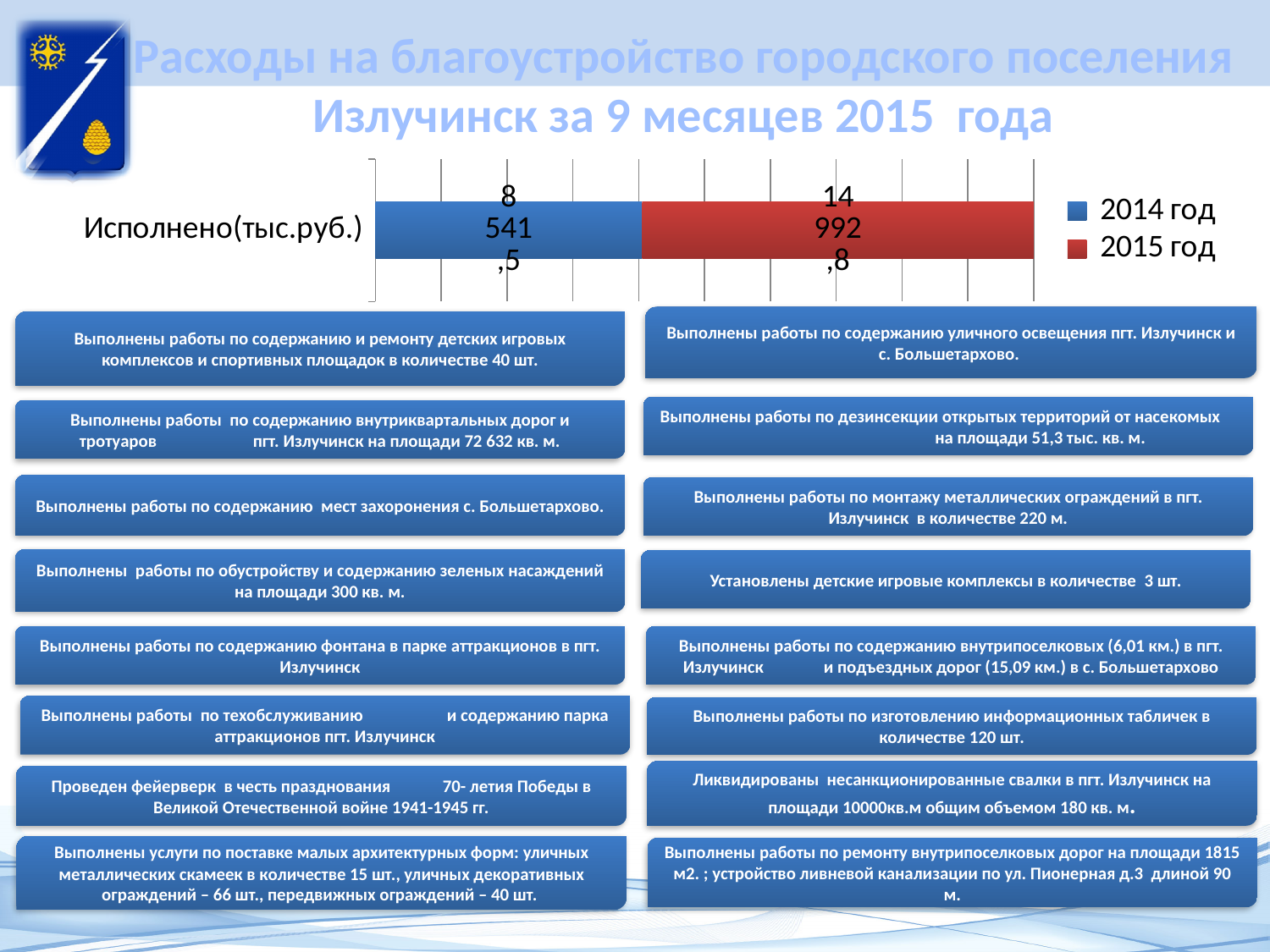
What is the difference between the 2015 год and 2014 год values? 6 451,3 Which series has the larger value, 2014 год or 2015 год? 2015 год How many categories are shown on the chart's axis? 1 What colour represents 2015 год in the chart? Red What is the category label shown on the chart's axis? Исполнено(тыс.руб.) What is the value for 2015 год in the chart? 14 992,8 What kind of chart is shown on the slide? Stacked bar chart What is the total of the stacked bar for Исполнено(тыс.руб.)? 23 534,3 Which year has the lowest value in the chart? 2014 год Which year has the highest value in the chart? 2015 год What is the value for 2014 год in the chart? 8 541,5 How many series does the legend list? 2